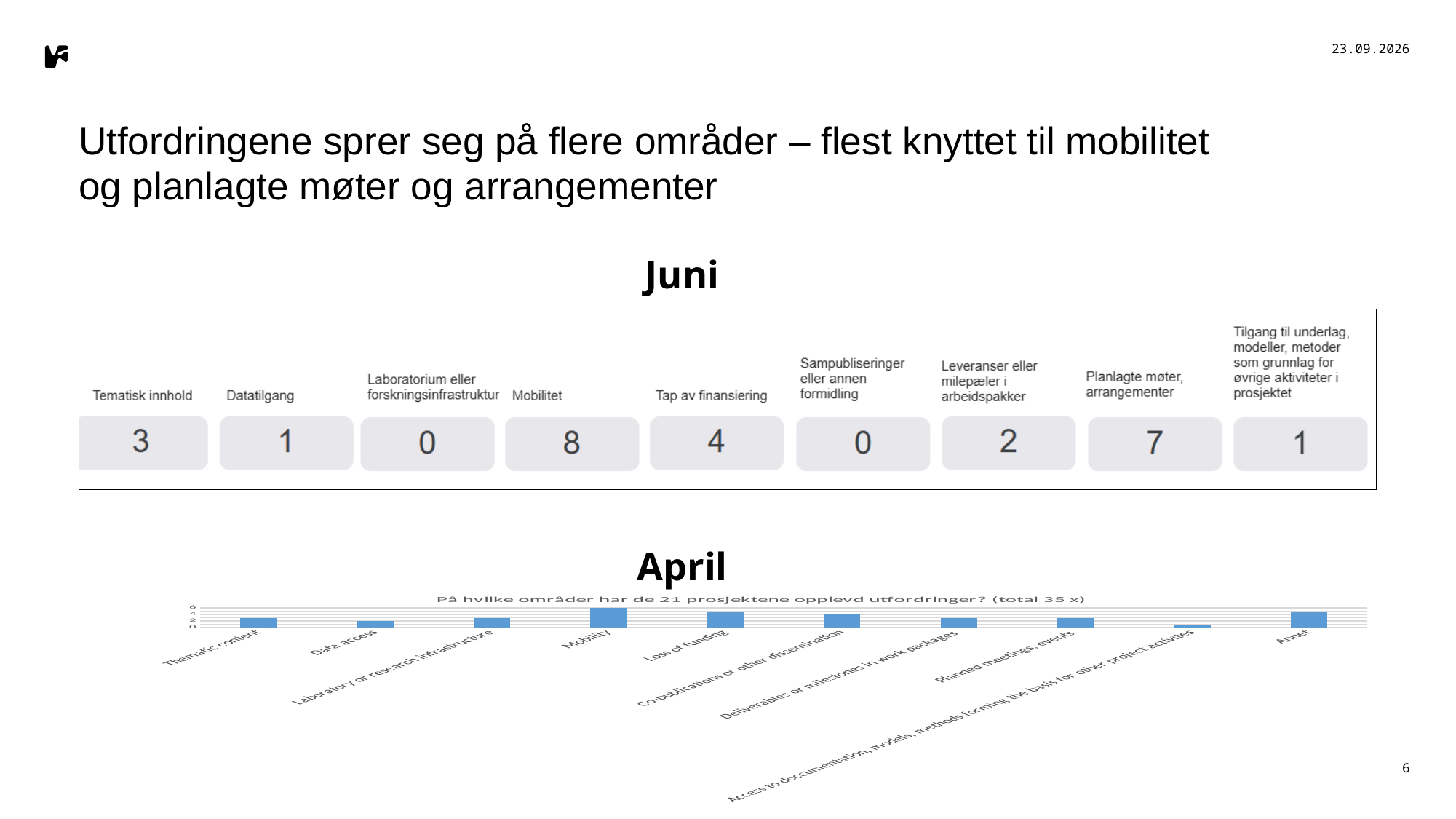
In the Juni chart, what is the difference between Mobilitet and Planlagte møter, arrangementer? 1 In the April chart, how many categories are shown on the x axis? 10 In the Juni chart, what is the value for Mobilitet? 8 What kind of chart is the April chart? Bar chart In the April chart, which category has the tallest bar? Mobility In the Juni chart, what is the value for Tap av finansiering? 4 In the Juni chart, what is the value for Planlagte møter, arrangementer? 7 In the Juni chart, which is larger: Tematisk innhold or Tap av finansiering? Tap av finansiering In the Juni chart, how many categories are shown? 9 In the April chart, which category has the shortest bar? Access to documentation, models, methods forming the basis for other project activities In the April chart, is the value for Mobility greater or less than 4? greater In the Juni chart, which category has the highest value? Mobilitet